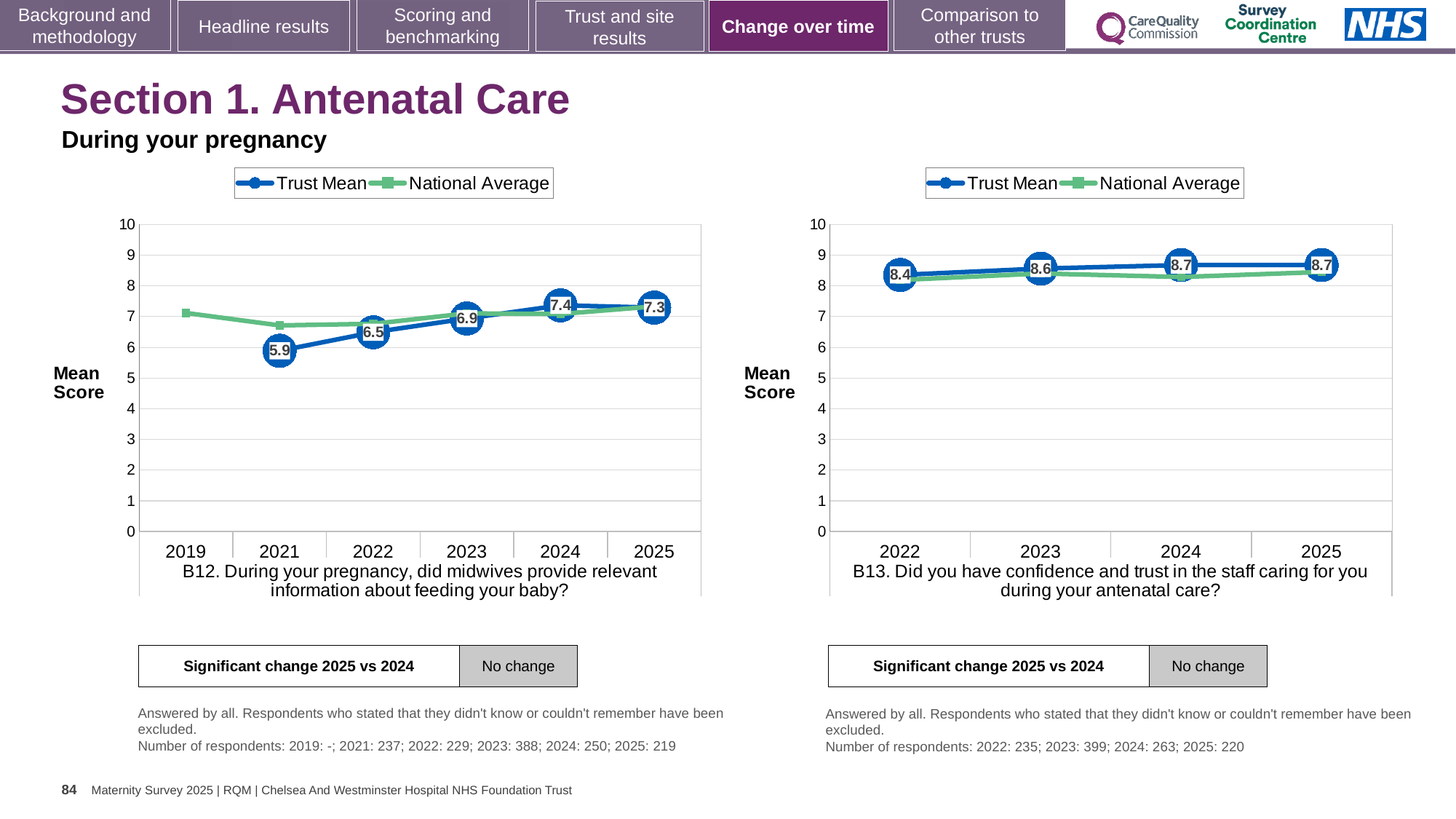
In the B12 chart (left), what is the difference between the Trust Mean scores for 2024 and 2021? 1.5 In the B12 chart (left), which year has the highest Trust Mean score? 2024 In the B12 chart (left), what is the Trust Mean score for 2025? 7.3 In the B12 chart (left), is the Trust Mean score for 2022 greater or less than 7? less How many series does the legend of the B12 chart (left) list? 2 How many years are shown on the x axis of the B13 chart (right)? 4 In the B12 chart (left), which year has the lowest Trust Mean score? 2021 In the B12 chart (left), what is the Trust Mean score for 2021? 5.9 In the B13 chart (right), what is the Trust Mean score for 2022? 8.4 In the B13 chart (right), what is the difference between the Trust Mean scores for 2025 and 2022? 0.3 What type of chart is the B13 chart (right)? Line chart In the B13 chart (right), is the Trust Mean score for 2023 greater or less than 8? greater